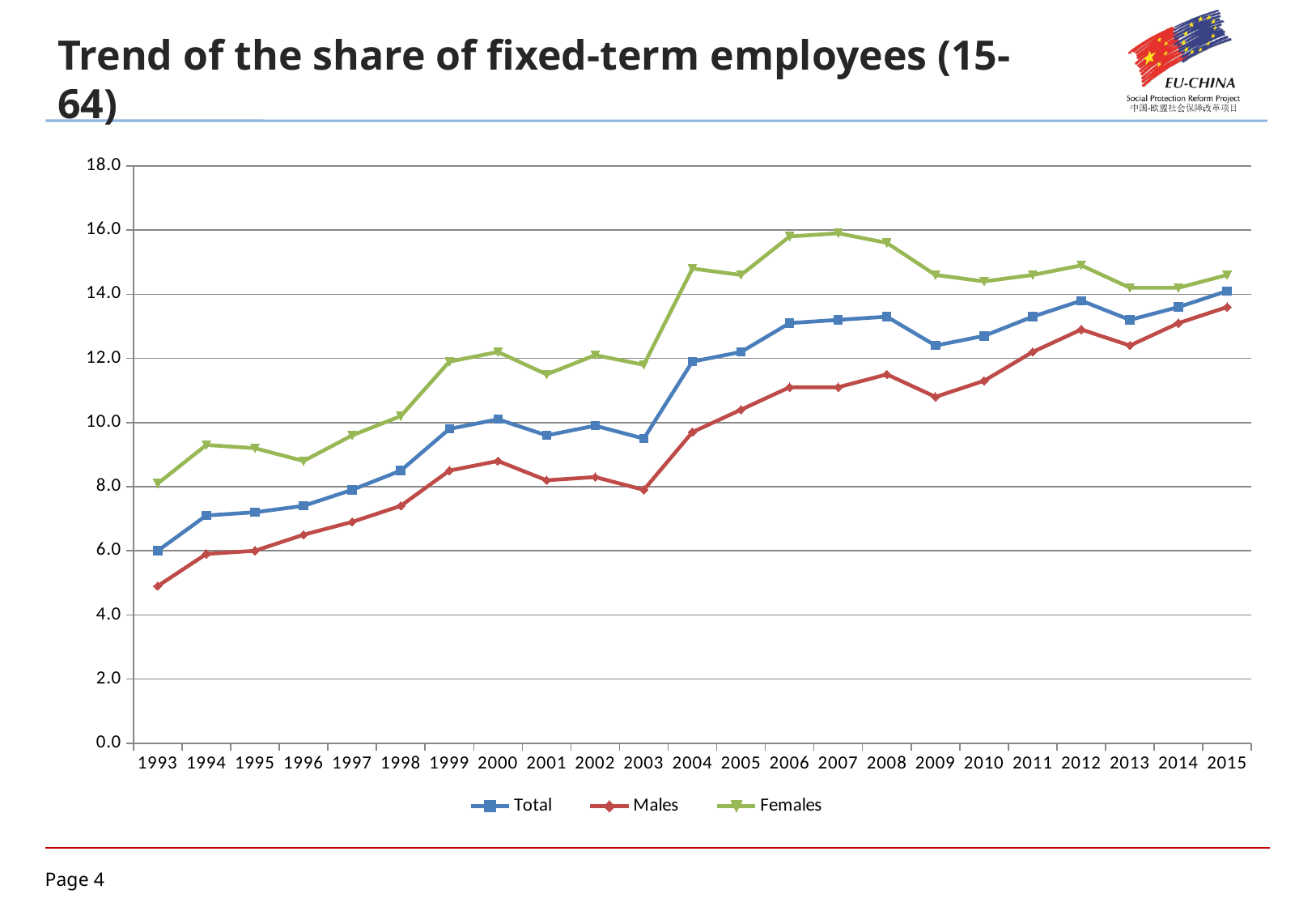
What is the value for Total in 1993? 6.0 Is the value for Males in 2009 greater or less than 12.0? less Is the value for Females in 2007 greater or less than 14.0? greater What kind of chart is shown on the slide? Line chart In 2010, which is larger, the value for Females or the value for Males? Females In which year is the Females series at its lowest? 1993 How many years are plotted along the x axis? 23 In which year is the Males series at its highest? 2015 How many series does the legend list? 3 Overall, do the values for Total rise or fall from 1993 to 2015? Rise In which year is the Males series at its lowest? 1993 Is the value for Males in 1993 greater or less than 6.0? less